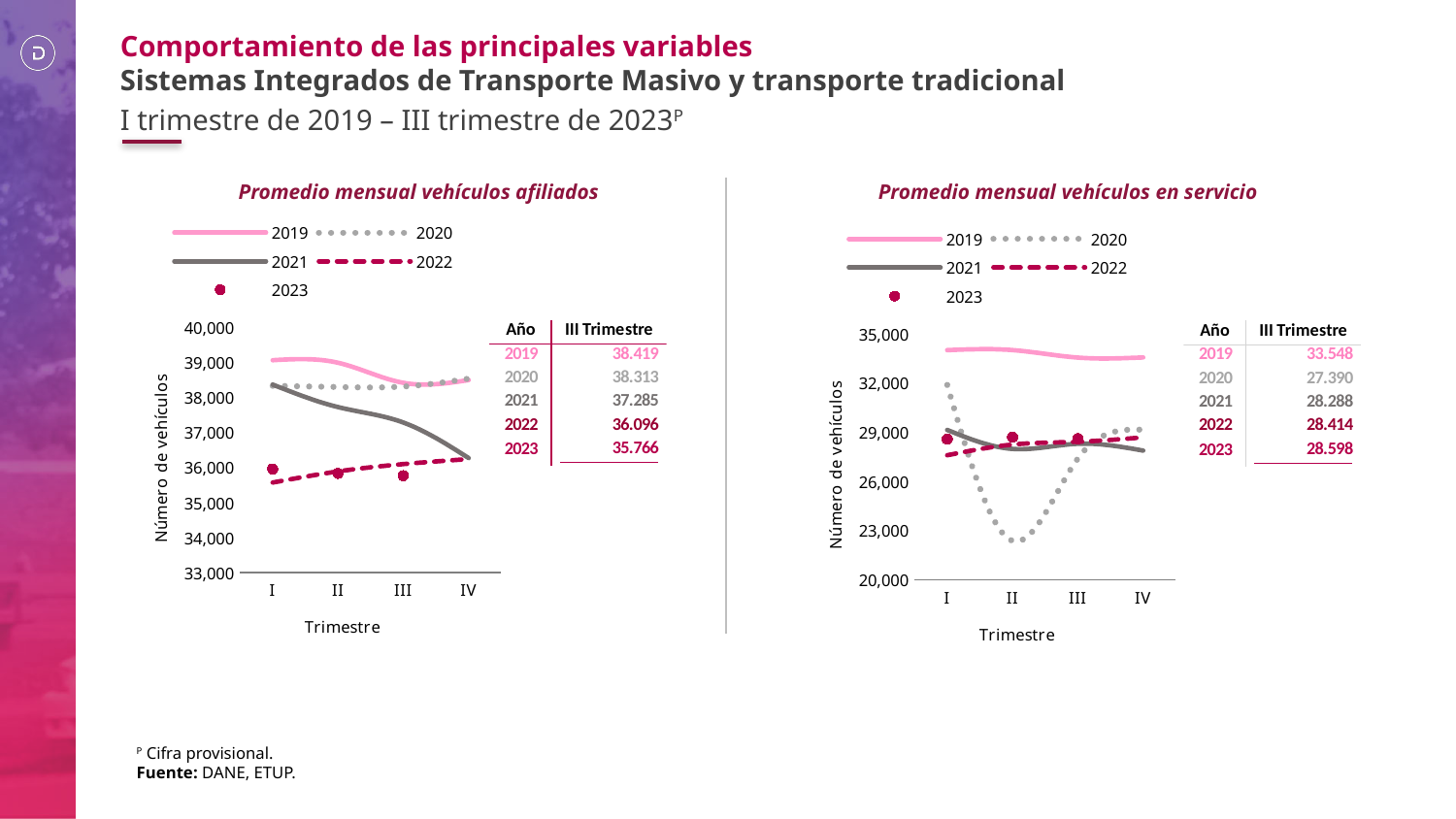
In the 'Promedio mensual vehículos afiliados' chart, is the value for 2023 in trimestre I greater or less than 37,000? less In the 'Promedio mensual vehículos en servicio' chart, which year has the lowest III Trimestre value in the table? 2020 In the 'Promedio mensual vehículos afiliados' chart, what is the difference between the III Trimestre values for 2019 and 2023? 2.653 What kind of chart is 'Promedio mensual vehículos afiliados'? line chart In the 'Promedio mensual vehículos afiliados' chart, which year has the highest III Trimestre value in the table? 2019 How many trimestres are shown on the x axis of the 'Promedio mensual vehículos afiliados' chart? 4 In the 'Promedio mensual vehículos en servicio' chart, which III Trimestre value is larger, 2022 or 2023? 2023 In the 'Promedio mensual vehículos afiliados' chart, does the 2021 line rise or fall from trimestre I to trimestre IV? fall In the 'Promedio mensual vehículos afiliados' chart, what is the III Trimestre value for 2019 shown in the table? 38.419 In the 'Promedio mensual vehículos en servicio' chart, what is the III Trimestre value for 2020 shown in the table? 27.390 How many series does the legend of the 'Promedio mensual vehículos en servicio' chart list? 5 In the 'Promedio mensual vehículos en servicio' chart, is the value for 2019 in trimestre I greater or less than 32,000? greater